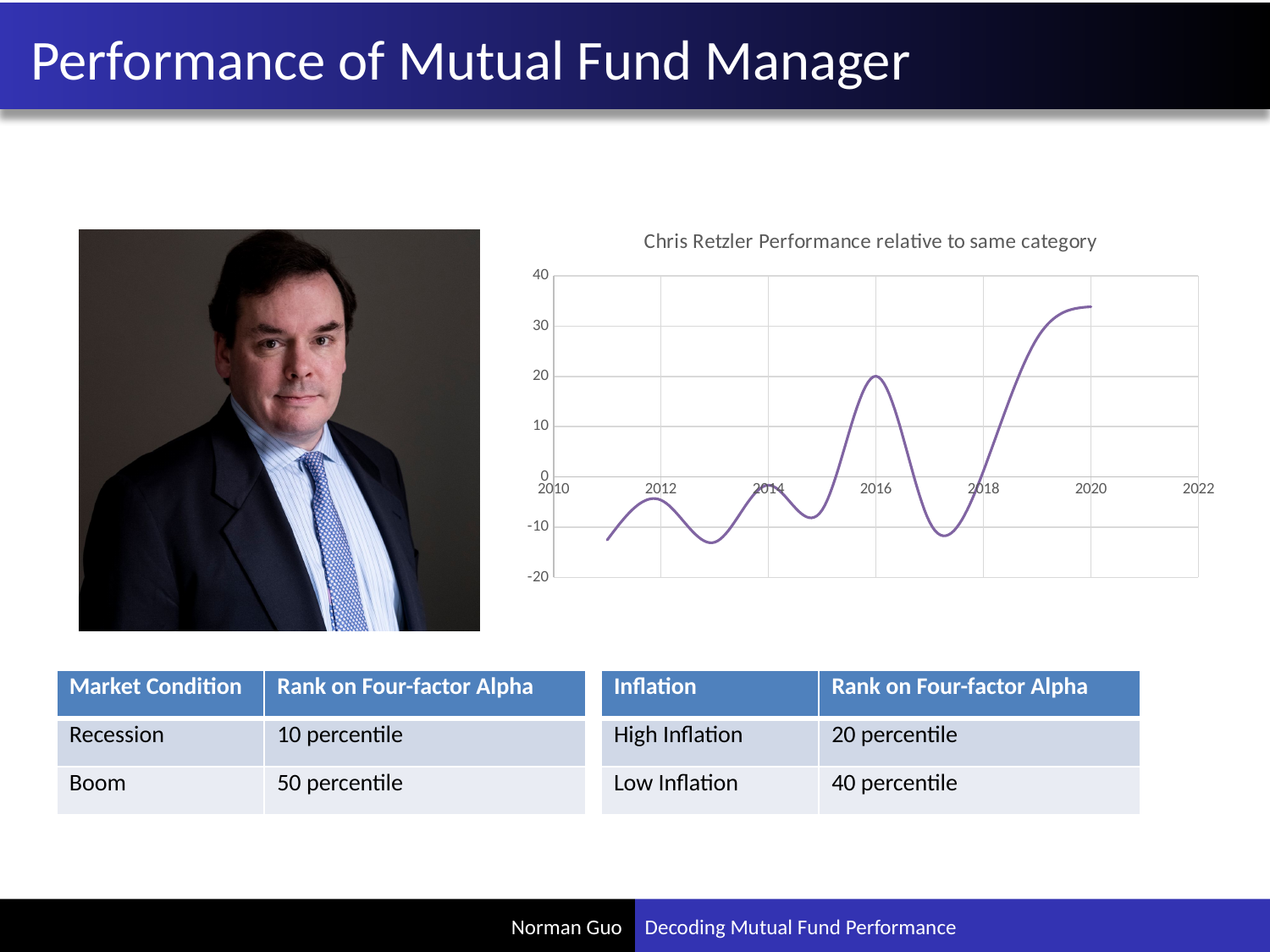
Which year has the larger value, 2016 or 2017? 2016 Is the value for 2017 greater or less than 0? less What kind of chart is shown on the slide? line chart Overall, does the line rise or fall from 2011 to 2020? rise Is the value for 2019 greater or less than 20? greater What is the title of the chart? Chris Retzler Performance relative to same category Which year has the larger value, 2016 or 2019? 2019 Is the value for 2020 greater or less than 30? greater In which year does the chart reach its highest value? 2020 What is the highest value shown on the chart's vertical axis? 40